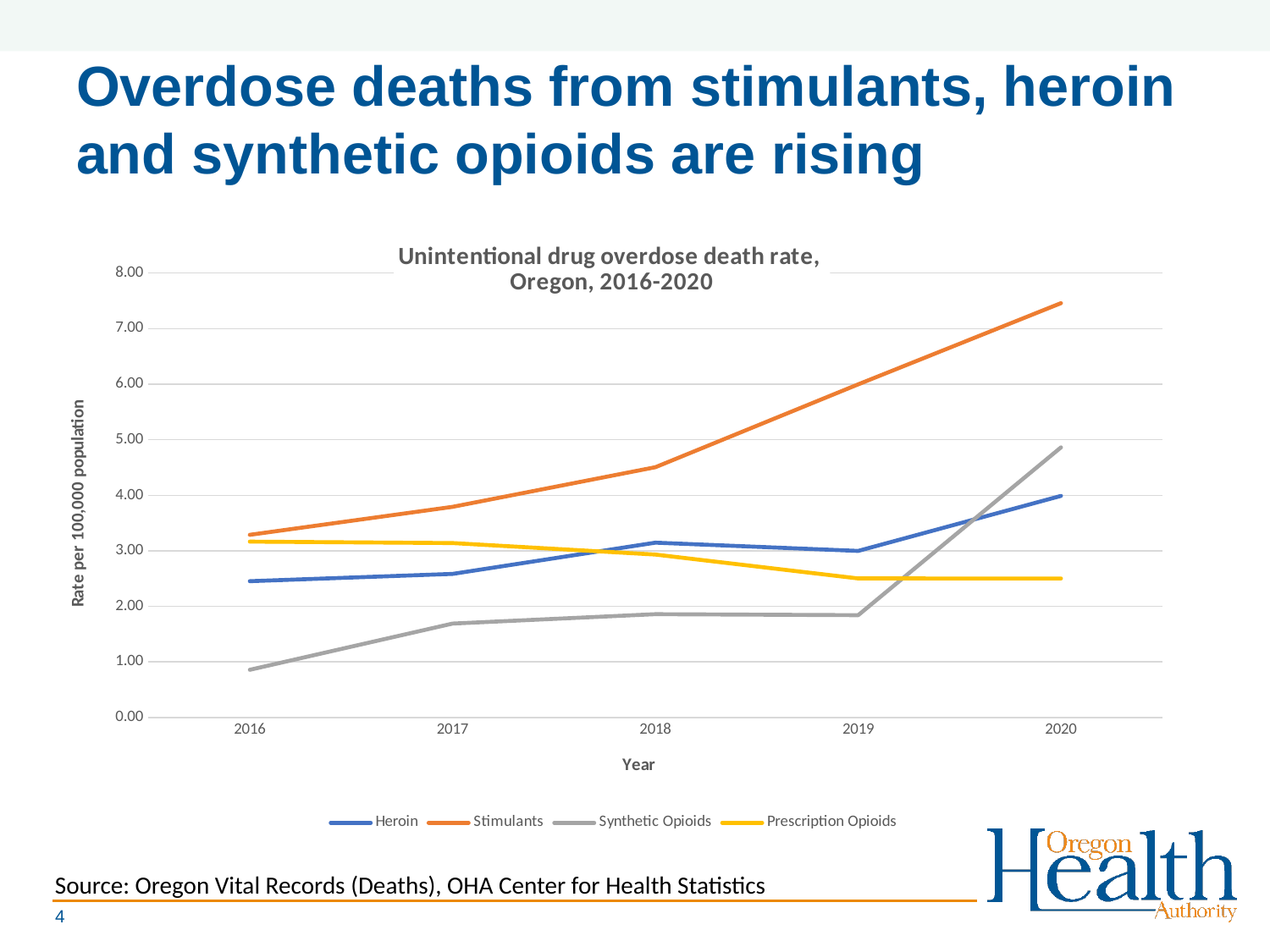
Which series has the highest death rate in 2020? Stimulants What is the title of the chart? Unintentional drug overdose death rate, Oregon, 2016-2020 What kind of chart is shown on the slide? Line chart In 2020, which is higher: Synthetic Opioids or Heroin? Synthetic Opioids Does the Prescription Opioids line rise or fall from 2016 to 2020? Fall How many series does the legend list? 4 Is the value for Synthetic Opioids in 2016 greater or less than 1.00? less Does the Stimulants line rise or fall from 2016 to 2020? Rise Which series has the lowest death rate in 2016? Synthetic Opioids Is the value for Stimulants in 2020 greater or less than 7.00? greater How many years are shown on the x axis? 5 What is the label on the y axis? Rate per 100,000 population